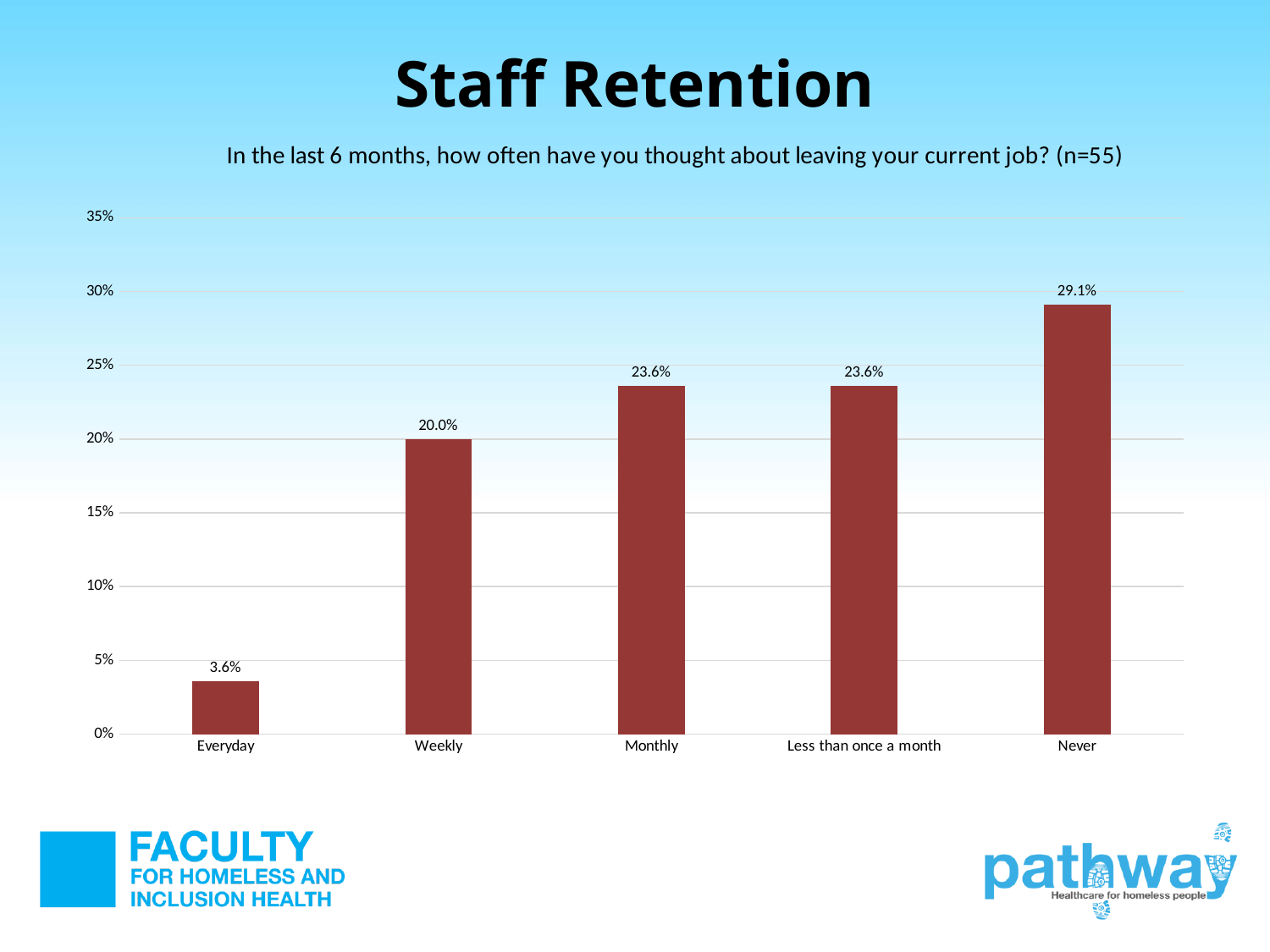
What percentage of respondents said they thought about leaving their job Everyday? 3.6% How many categories are shown on the x axis? 5 What is the value for Weekly? 20.0% Which is larger, the value for Weekly or the value for Never? Never What kind of chart is shown on the slide? bar chart What is the sample size (n) stated in the chart's subtitle? 55 What is the difference between the values for Monthly and Weekly? 3.6% Is the value for Monthly greater or less than 20%? greater Which category has the lowest value? Everyday What is the value for Never? 29.1% What is the difference between the values for Never and Everyday? 25.5% Which category has the highest value? Never